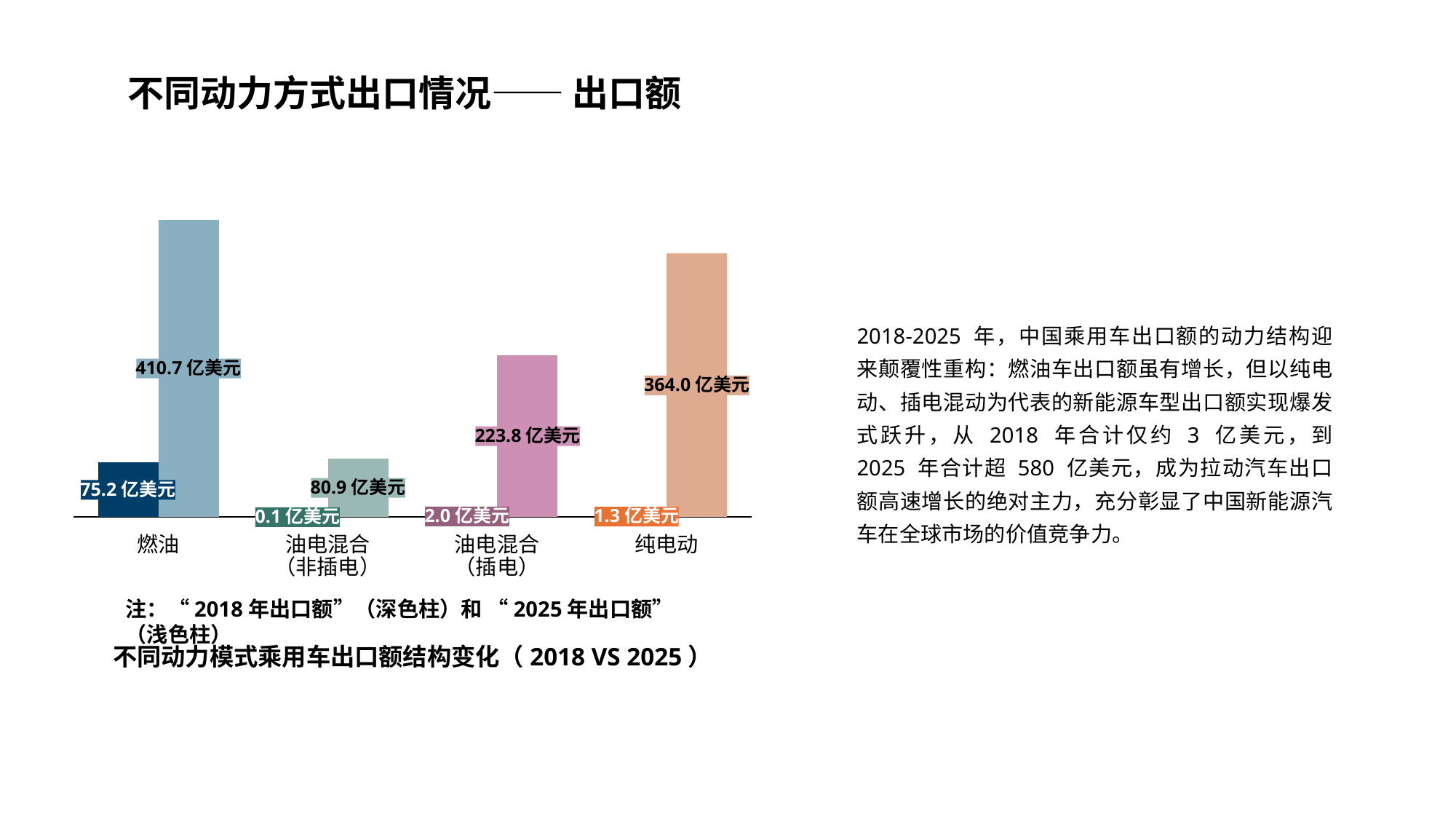
How many power-type categories are shown on the x axis? 4 What is the 2025 export value for 燃油 (light bar)? 410.7 亿美元 How many years (series) are compared for each category? 2 According to the note, what do the dark bars represent? 2018 年出口额 What is the 2025 export value for 油电混合（插电）? 223.8 亿美元 Which category has the lowest 2018 export value? 油电混合（非插电） What is the 2018 export value for 油电混合（非插电）? 0.1 亿美元 Which is larger: the 2025 export value for 纯电动 or for 油电混合（插电）? 纯电动 What kind of chart is shown on the slide? Bar chart Which category has the highest 2025 export value? 燃油 What is the 2018 export value for 纯电动 (dark bar)? 1.3 亿美元 What is the difference between the 2025 and 2018 export values for 纯电动? 362.7 亿美元